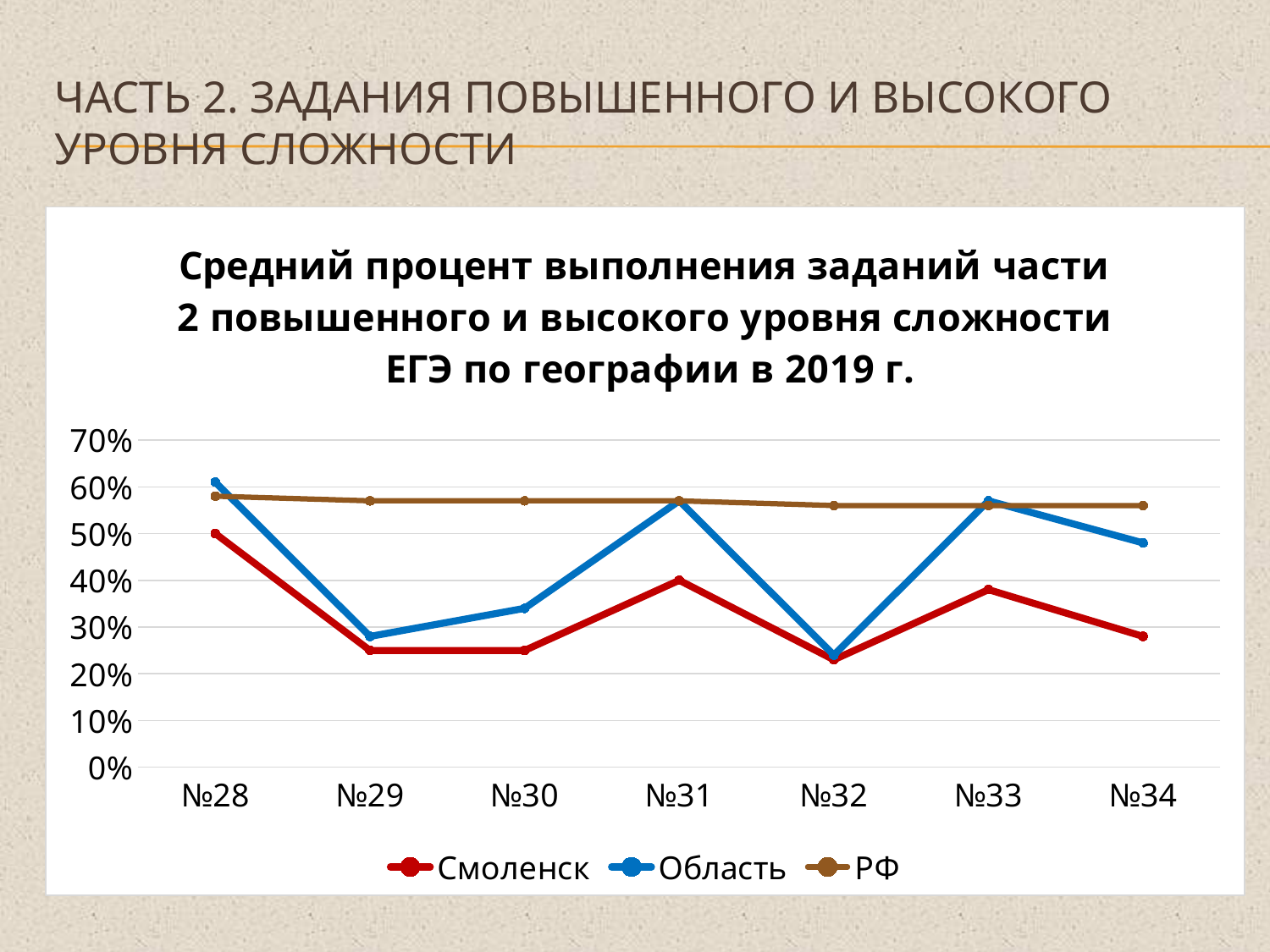
Does the Смоленск series rise or fall from №28 to №29? fall For which task does the Смоленск series reach its highest value? №28 At №28, which is larger: Область or Смоленск? Область Is the value for РФ at №30 greater or less than 50%? greater For which task does the Область series reach its lowest value? №32 How many series does the legend list? 3 How many task categories are shown on the x axis? 7 Is the value for Область at №32 greater or less than 30%? less Which series is drawn in red? Смоленск At №34, which is larger: РФ or Область? РФ What kind of chart is shown on the slide? line chart Is the value for Область at №34 greater or less than 50%? less